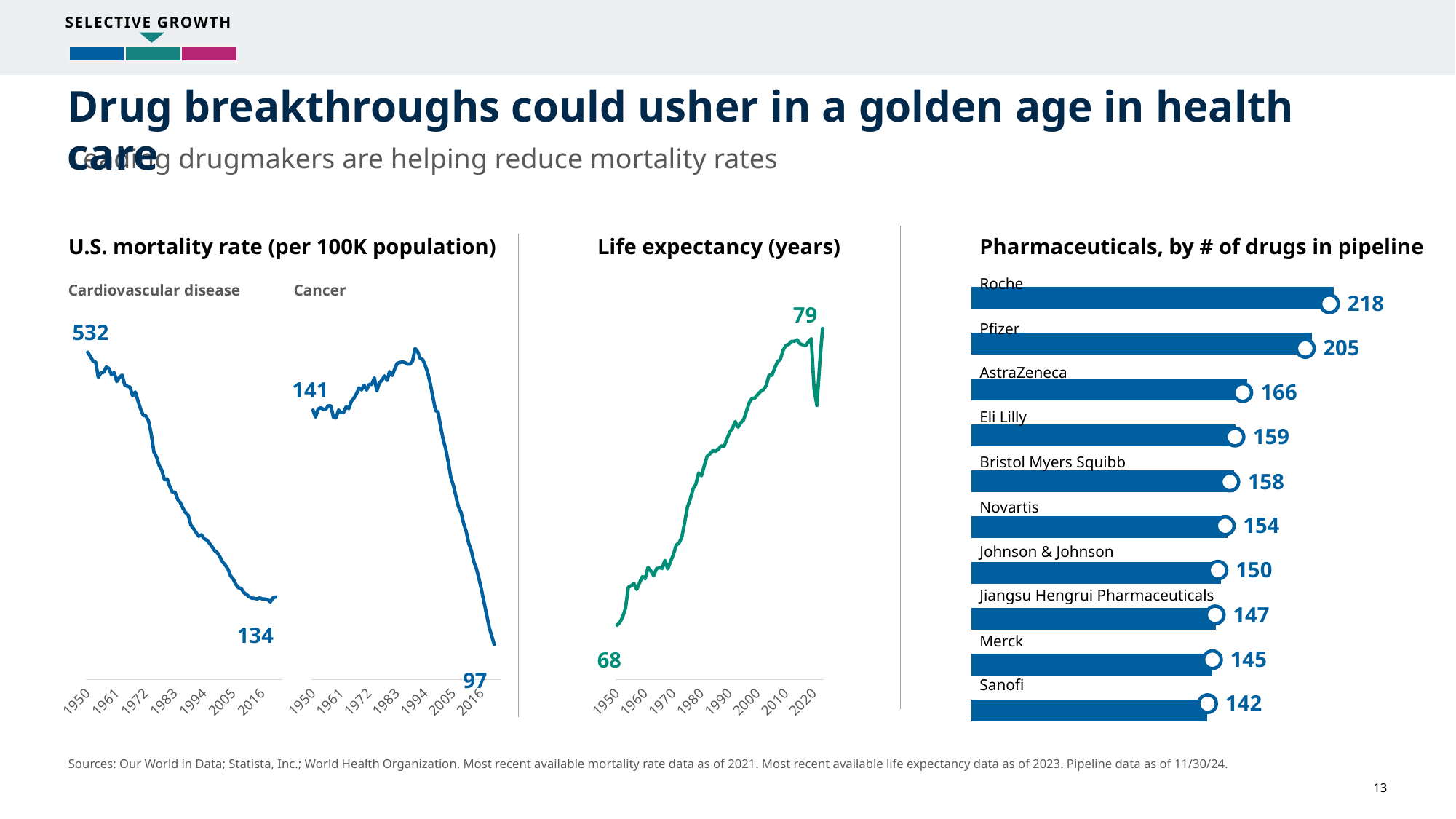
In the 'Pharmaceuticals, by # of drugs in pipeline' chart, what is the difference between Roche's and Pfizer's pipeline counts? 13 In the 'Pharmaceuticals, by # of drugs in pipeline' chart, which has more drugs in its pipeline, Novartis or Merck? Novartis In the 'Life expectancy (years)' chart, what is the highest labeled life expectancy value? 79 In the 'U.S. mortality rate (per 100K population)' chart, what is the most recent labeled value for cancer mortality? 97 In the 'Life expectancy (years)' chart, does life expectancy generally rise or fall from 1950 to 2020? Rise In the 'Pharmaceuticals, by # of drugs in pipeline' chart, how many drugs does Roche have in its pipeline? 218 In the 'Pharmaceuticals, by # of drugs in pipeline' chart, how many companies are listed? 10 In the 'U.S. mortality rate (per 100K population)' chart, what was the cardiovascular disease mortality rate at the start of the series in 1950? 532 In the 'Pharmaceuticals, by # of drugs in pipeline' chart, which company has the fewest drugs in its pipeline? Sanofi In the 'Pharmaceuticals, by # of drugs in pipeline' chart, which company has the most drugs in its pipeline? Roche What kind of chart is 'Pharmaceuticals, by # of drugs in pipeline'? Bar chart In the 'U.S. mortality rate (per 100K population)' chart, what is the difference between the first and last labeled values for cardiovascular disease? 398